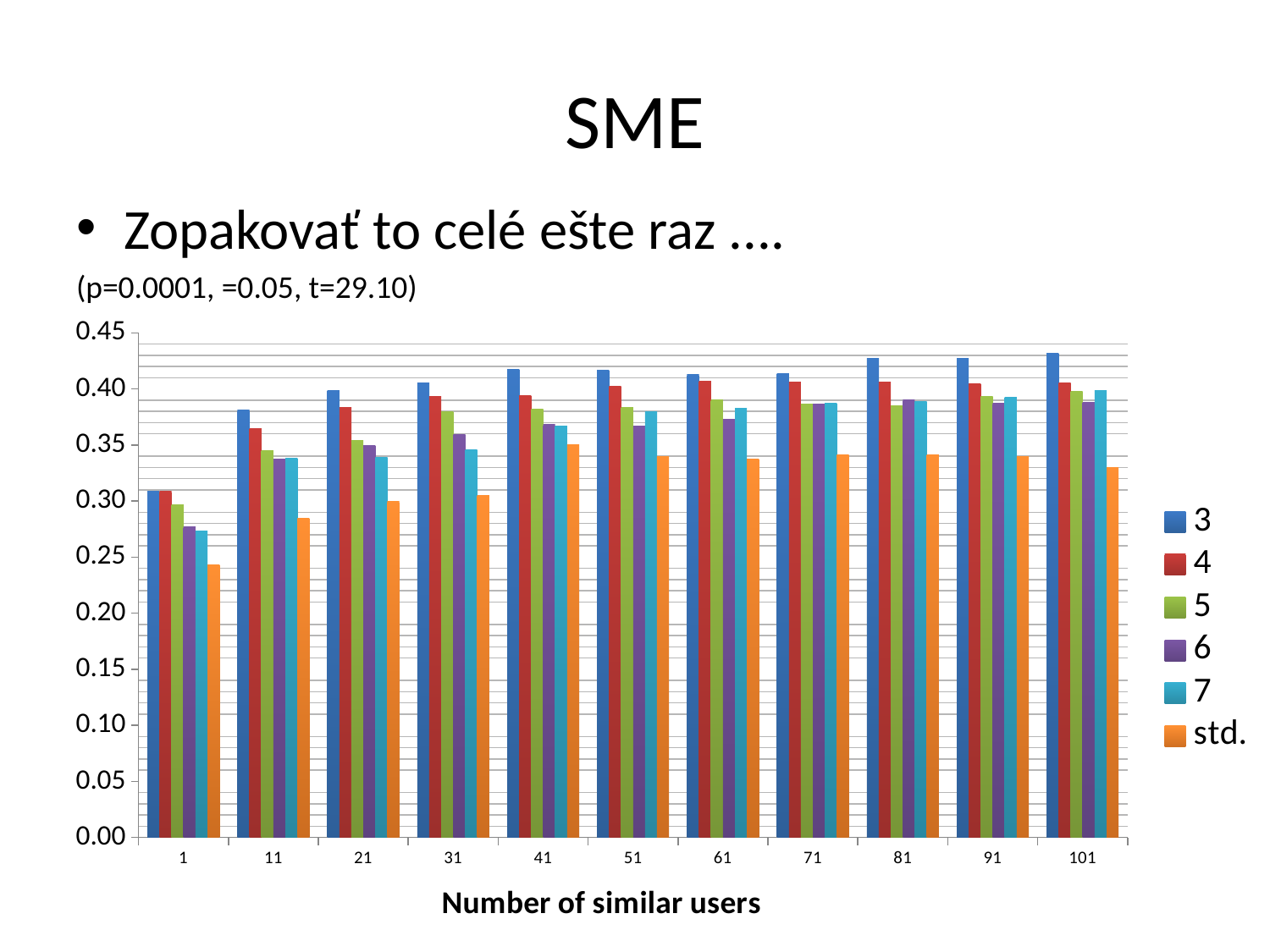
How many series does the legend list? 6 Which series is listed last in the legend? std. Is the value for series std. at 101 similar users greater or less than 0.35? less What kind of chart is shown on the slide? bar chart What is the title of the x axis? Number of similar users Is the value for series 3 at 101 similar users greater or less than 0.40? greater Is the value for series 4 at 11 similar users greater or less than 0.35? greater Which series has the lowest value at 41 similar users? std. For series 3, is the value at 1 similar user or at 11 similar users larger? 11 Which series has the highest value at 101 similar users? 3 How many categories are shown on the x axis? 11